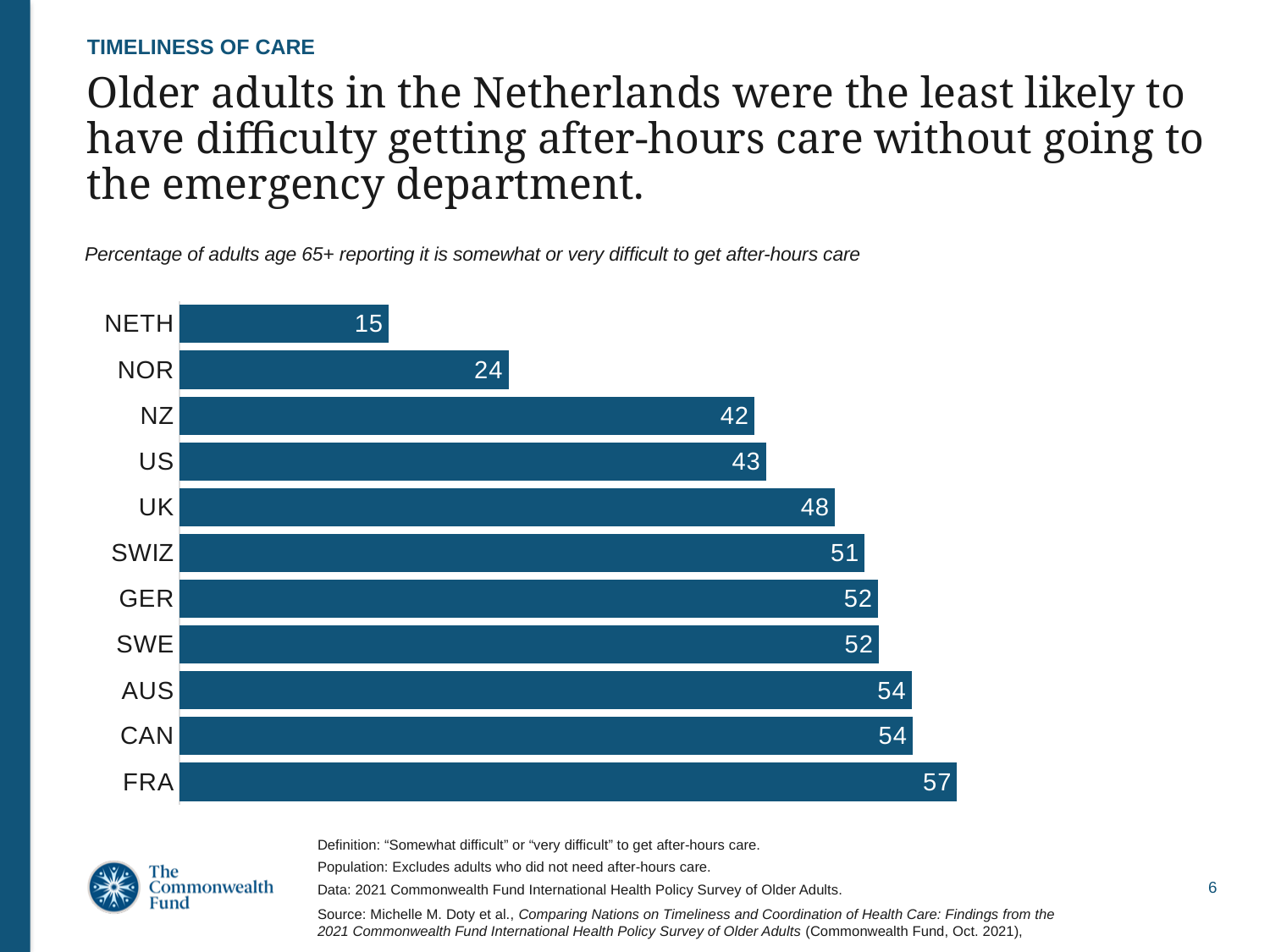
Which country has the lowest value? NETH Which two countries both have a value of 54? AUS and CAN Which is larger, the value for NZ or the value for UK? UK What is the value for NETH? 15 How many countries are shown in the chart? 11 What is the value for US? 43 Which country has the highest value? FRA What is the difference between the values for UK and NOR? 24 What kind of chart is shown on the slide? bar chart What does the chart subtitle say is being measured? Percentage of adults age 65+ reporting it is somewhat or very difficult to get after-hours care What is the difference between the values for FRA and NETH? 42 What is the value for SWIZ? 51